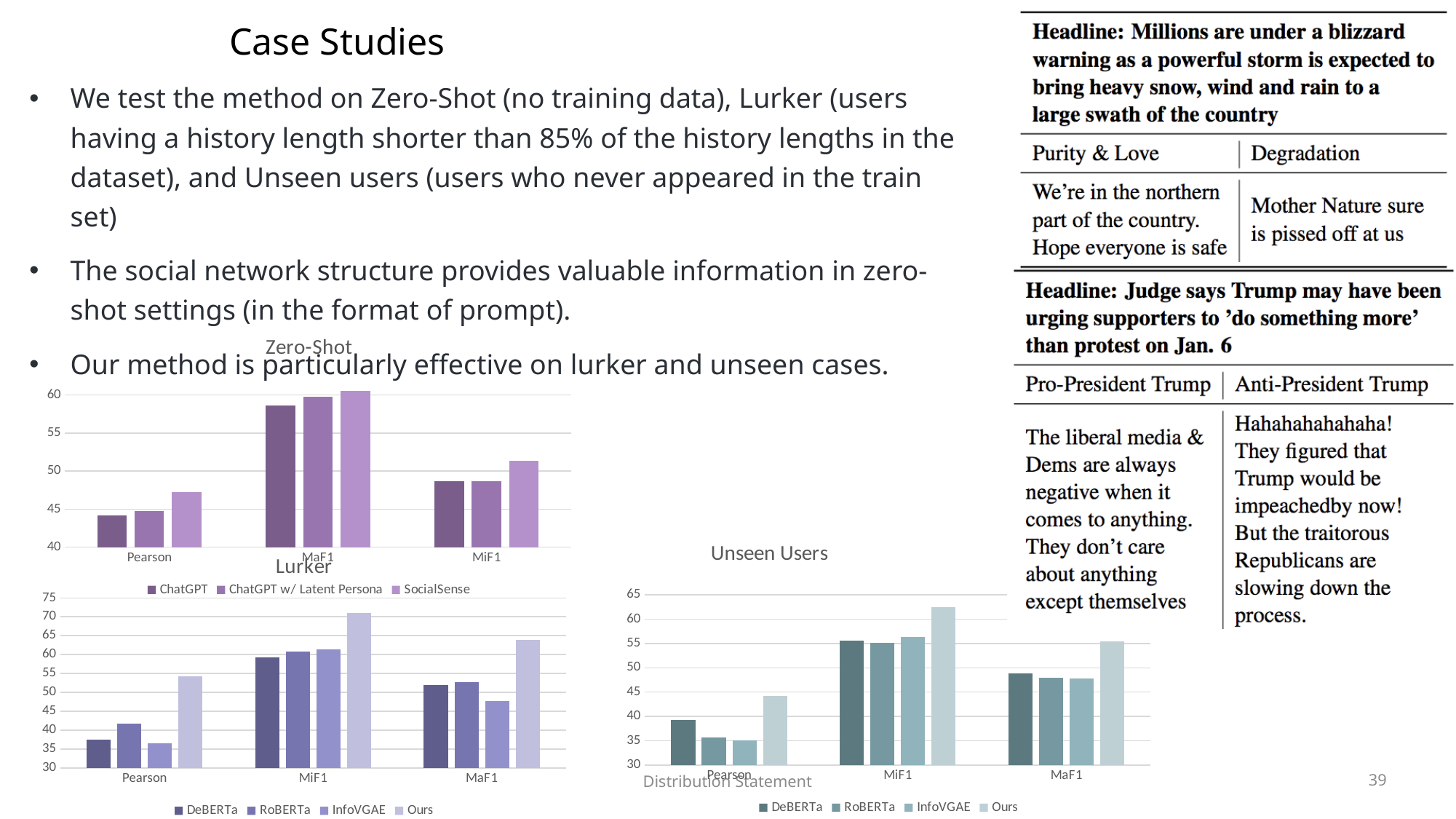
What are the legend entries of the Unseen Users chart? DeBERTa, RoBERTa, InfoVGAE, Ours In the Unseen Users chart, which series has the highest value for Pearson? Ours In the Lurker chart, how many categories are shown on the x axis? 3 In the Zero-Shot chart, is the SocialSense value for Pearson greater or less than 45? greater In the Lurker chart, which is larger for Pearson: RoBERTa or InfoVGAE? RoBERTa In the Lurker chart, is the Ours value for MiF1 greater or less than 65? greater In the Zero-Shot chart, which category has the highest SocialSense value? MaF1 What kind of chart is the Zero-Shot chart? bar chart In the Lurker chart, which series has the highest value for MiF1? Ours In the Unseen Users chart, is the Ours value for MaF1 greater or less than 50? greater In the Zero-Shot chart, how many series does the legend list? 3 In the Lurker chart, how many series does the legend list? 4